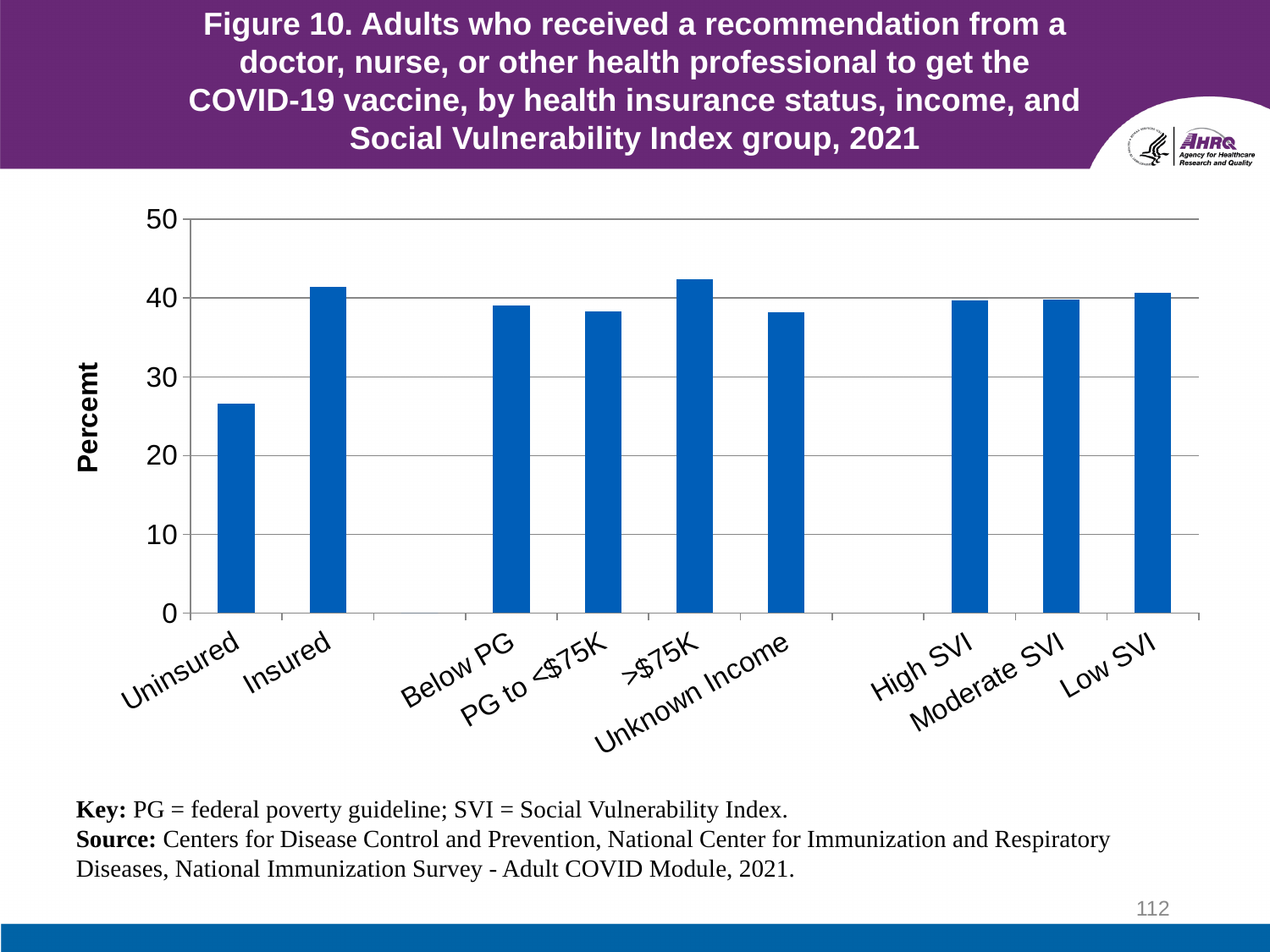
Which is larger, the value for >$75K or the value for Unknown Income? >$75K Is the value for Insured greater or less than 40? greater Is the value for Uninsured greater or less than 20? greater Is the value for Uninsured greater or less than 30? less What kind of chart is shown on the slide? bar chart Which is larger, the value for Insured or the value for Uninsured? Insured How many categories (bars) are plotted in the chart? 9 Which category has the lowest value in the chart? Uninsured What is the label on the vertical axis of the chart? Percemt